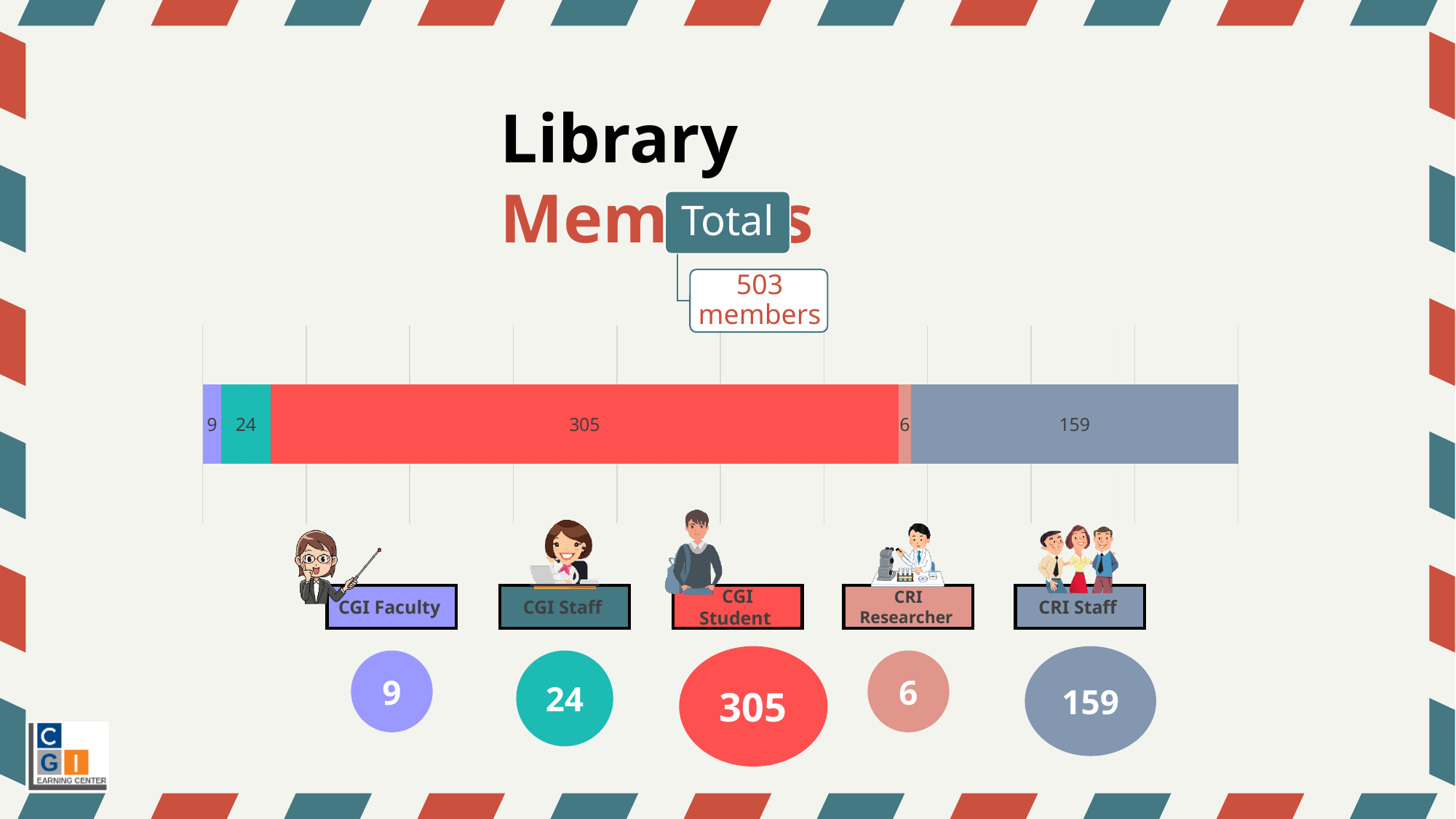
How many library members are CRI Researchers? 6 What colour is the CGI Student segment of the bar? red What kind of chart is shown on the slide? stacked bar chart Which is larger, the number of CGI Staff or the number of CGI Faculty? CGI Staff How many library members are CGI Students? 305 Which member category has the smallest value? CRI Researcher How many library members are CGI Faculty? 9 What is the total number of library members shown by the stacked bar? 503 How many library members are CRI Staff? 159 Which member category has the largest value? CGI Student How many member categories make up the stacked bar? 5 What is the difference between the number of CGI Students and CRI Staff? 146